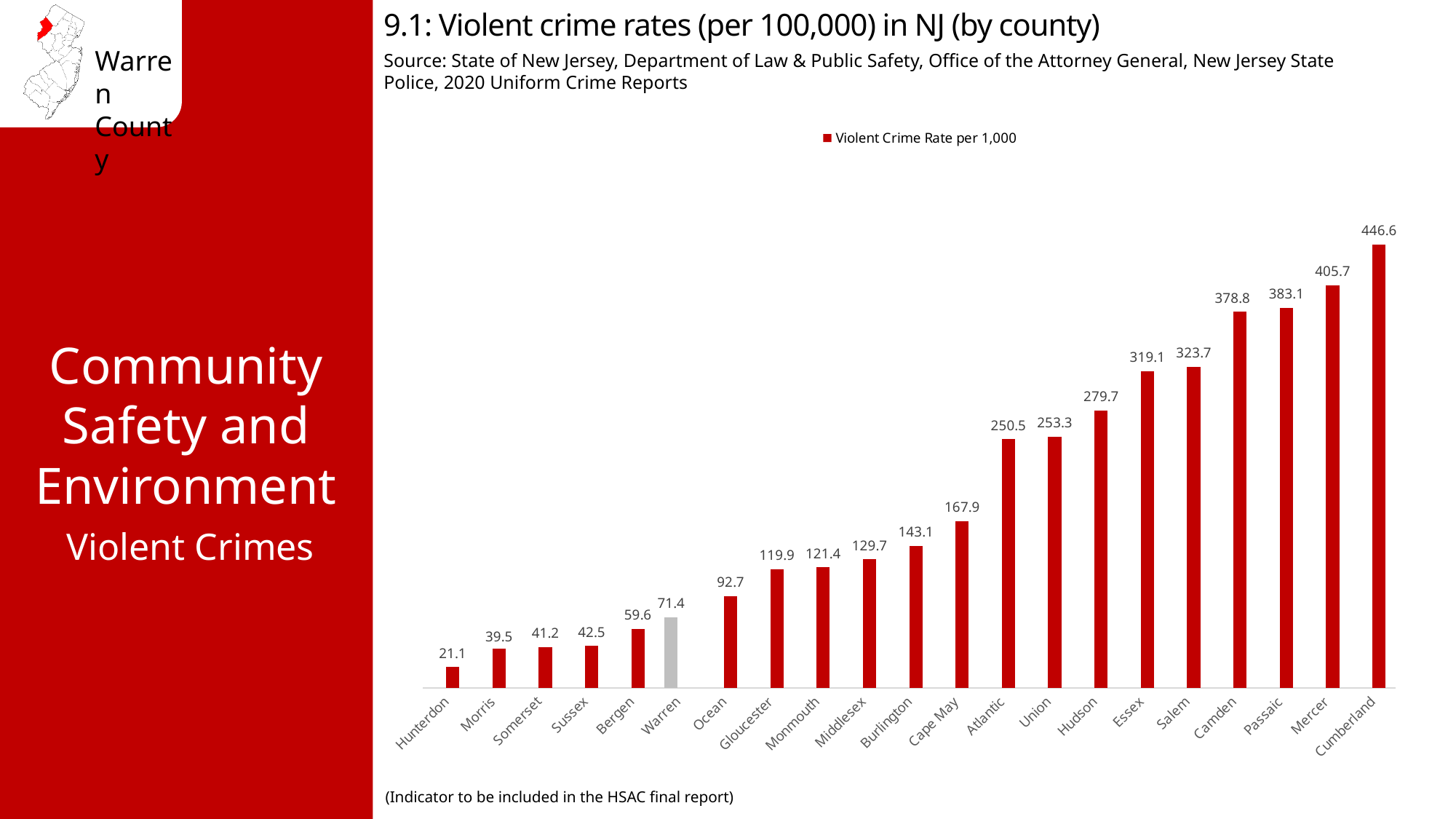
What is the difference between the violent crime rates of Warren and Bergen? 11.8 How many counties are shown on the chart? 21 Which county has a higher violent crime rate, Essex or Camden? Camden What is the violent crime rate for Hudson County? 279.7 Do the values rise or fall from left to right along the x axis? Rise What is the difference between the violent crime rates of Cumberland and Hunterdon? 425.5 What is the violent crime rate for Cape May County? 167.9 Which county has the lowest violent crime rate? Hunterdon Which county has the highest violent crime rate? Cumberland What kind of chart is shown on the slide? Bar chart What is the violent crime rate for Warren County? 71.4 How many series does the legend list? 1